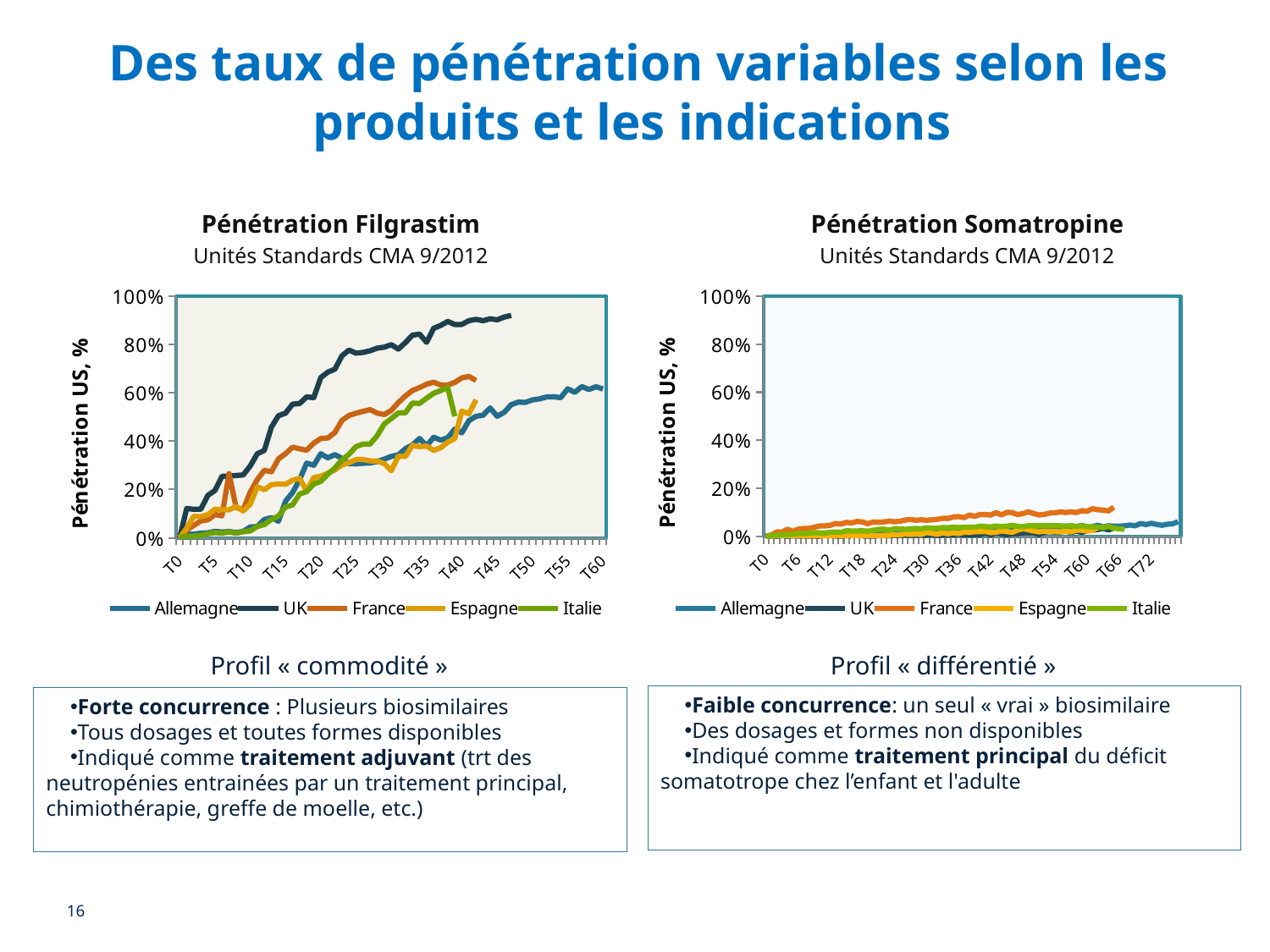
In the 'Pénétration Filgrastim' chart, which country's line reaches the highest penetration? UK What kind of chart is the 'Pénétration Filgrastim' chart? line chart In the 'Pénétration Filgrastim' chart, which is larger at T40: the value for UK or the value for Allemagne? UK How many series does the legend of the 'Pénétration Somatropine' chart list? 5 How many series does the legend of the 'Pénétration Filgrastim' chart list? 5 What is the y-axis label of the 'Pénétration Somatropine' chart? Pénétration US, % In the 'Pénétration Somatropine' chart, which country's line reaches the highest penetration? France In the 'Pénétration Filgrastim' chart, is the value for UK at T40 greater or less than 80%? greater In the 'Pénétration Filgrastim' chart, does the UK line rise or fall over time? rise In the 'Pénétration Filgrastim' chart, is the value for Allemagne at T60 greater or less than 80%? less What subtitle appears under the title 'Pénétration Filgrastim'? Unités Standards CMA 9/2012